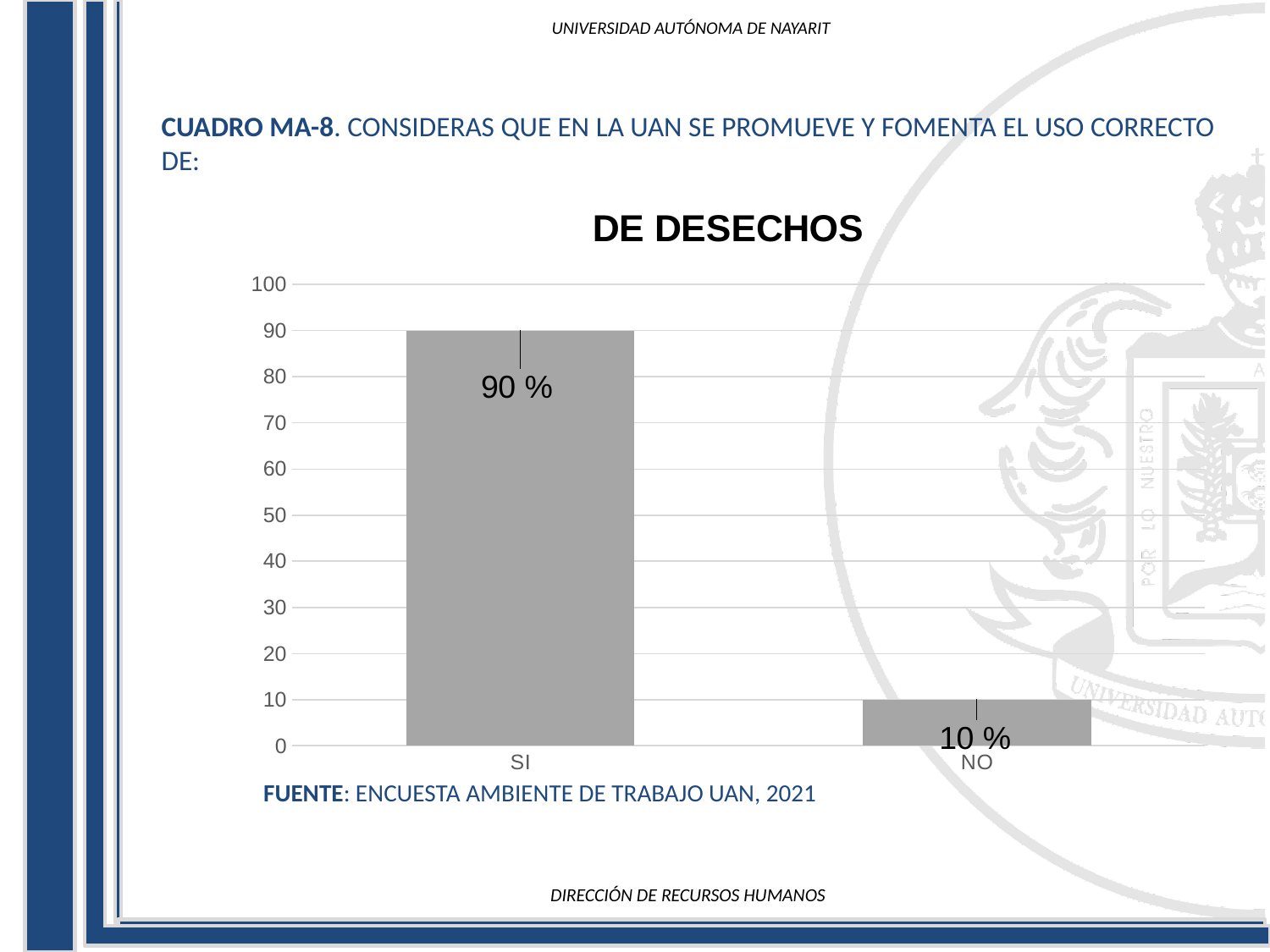
Which is larger, the value for SI or the value for NO? SI What is the highest value shown on the y axis? 100 What is the value for SI? 90 % Is the value for SI greater or less than 50? greater Which category has the lowest value? NO What is the value for NO? 10 % Is the value for NO greater or less than 20? less What is the difference between the values for SI and NO? 80 % What is the title of the chart? DE DESECHOS What kind of chart is shown? bar chart How many categories are shown on the x axis? 2 Which category has the highest value? SI